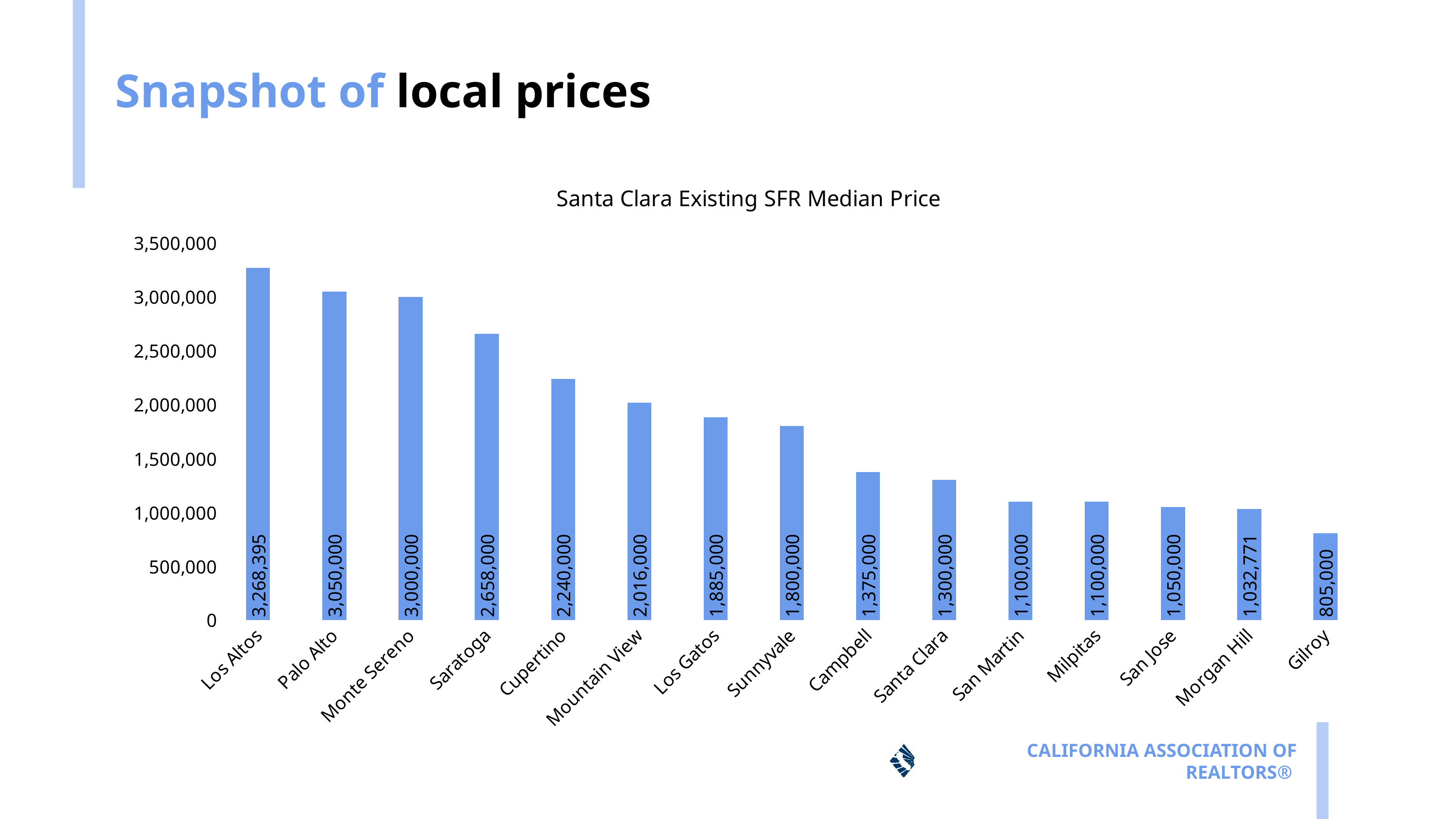
Which city has the lowest median price? Gilroy What is the title of the chart? Santa Clara Existing SFR Median Price Is the value for Mountain View greater or less than 2,000,000? greater How many cities are shown in the chart? 15 What is the median price for Morgan Hill? 1,032,771 What is the difference between the median prices of Palo Alto and Monte Sereno? 50,000 What is the median price for Cupertino? 2,240,000 What is the difference between the median prices of Saratoga and Gilroy? 1,853,000 Which city has the highest median price? Los Altos What is the median price for Los Altos? 3,268,395 Which has a higher median price, Los Gatos or Sunnyvale? Los Gatos What kind of chart is shown on the slide? bar chart